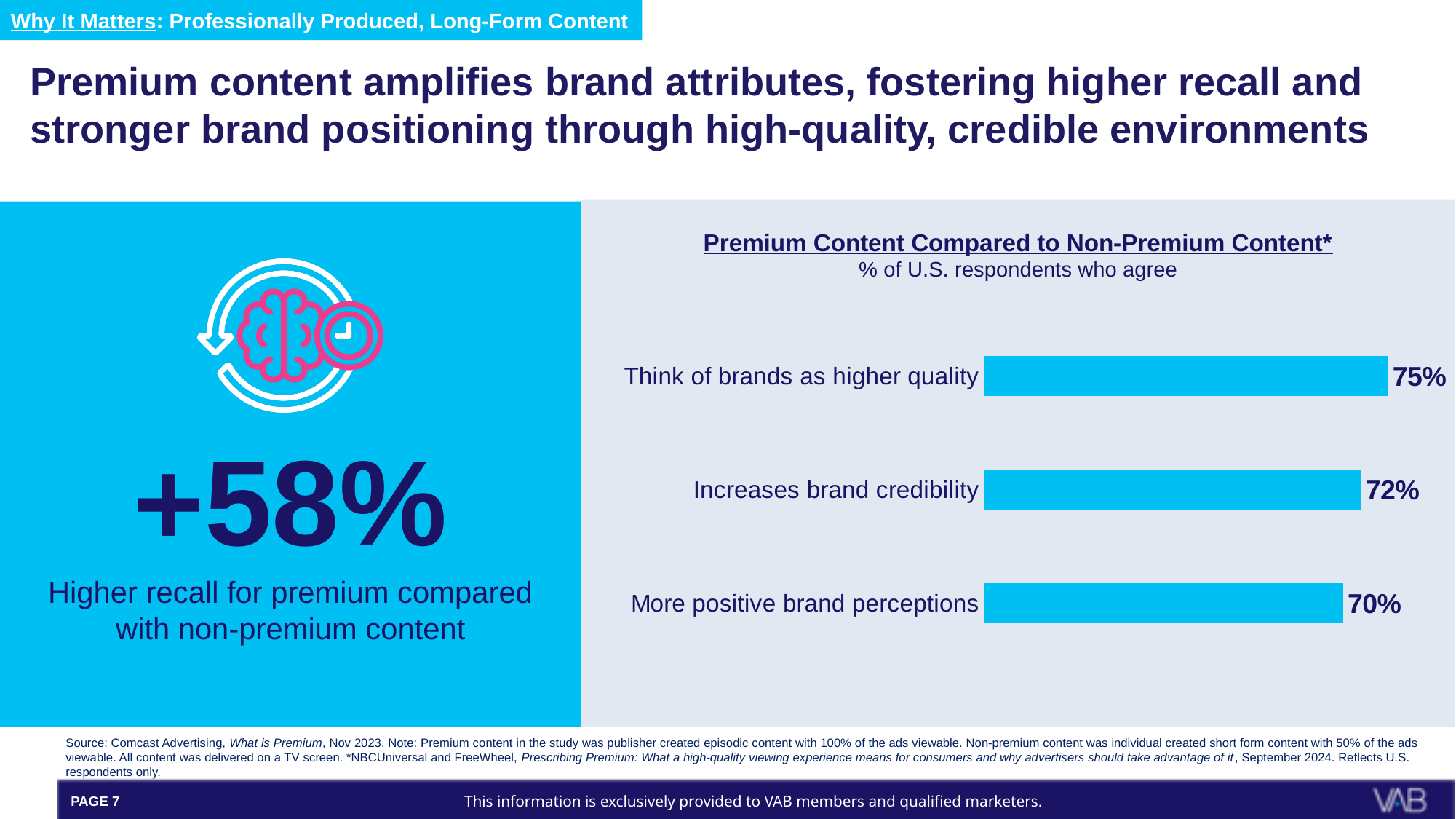
What does the chart's subtitle say the values represent? % of U.S. respondents who agree Which category has the lowest percentage of respondents who agree? More positive brand perceptions What percentage of U.S. respondents agree that premium content leads to more positive brand perceptions? 70% What is the difference in percentage points between 'Think of brands as higher quality' and 'More positive brand perceptions'? 5 percentage points Which category has the highest percentage of respondents who agree? Think of brands as higher quality What is the title of the chart? Premium Content Compared to Non-Premium Content* What kind of chart is used to show the premium vs. non-premium content comparison? Bar chart How many categories are shown in the chart? 3 Which is larger: the value for 'Think of brands as higher quality' or the value for 'Increases brand credibility'? Think of brands as higher quality What is the difference in percentage points between 'Increases brand credibility' and 'More positive brand perceptions'? 2 percentage points What percentage of U.S. respondents agree that premium content increases brand credibility? 72% What percentage of U.S. respondents agree that premium content makes them think of brands as higher quality? 75%